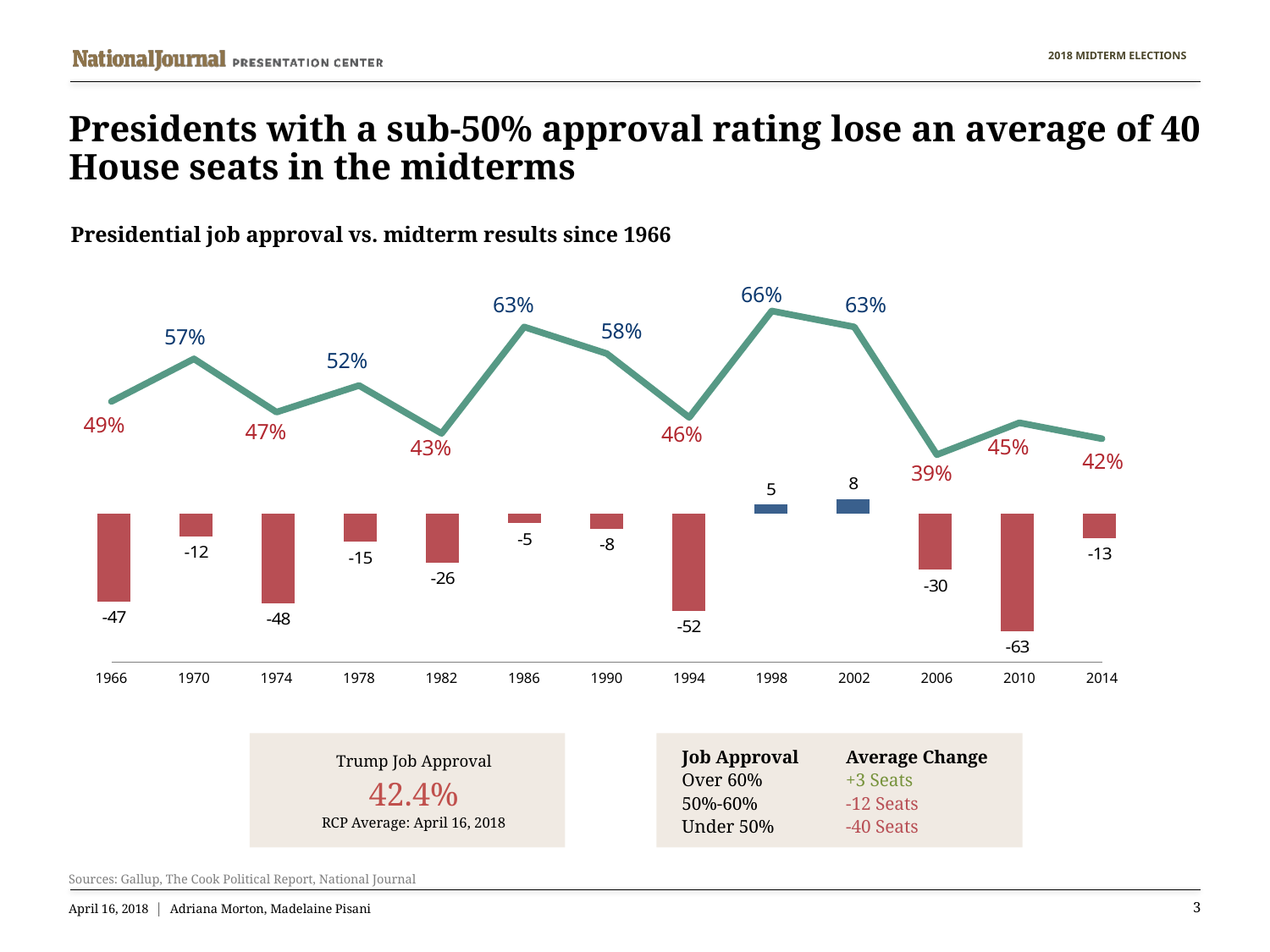
What is the difference between the approval rating in 1986 and in 1982? 20 percentage points What is the subtitle of the chart? Presidential job approval vs. midterm results since 1966 In which year was the presidential job approval rating lowest? 2006 What was the midterm House seat change in 2010? -63 Which year had a higher approval rating, 1970 or 1990? 1990 In which year was the largest loss of House seats recorded? 2010 What was the midterm House seat change in 2002? 8 In how many years shown did the president's party gain House seats? 2 What was the presidential job approval rating in 2006? 39% In which year was the presidential job approval rating highest? 1998 How many midterm years are shown on the x axis? 13 What was the presidential job approval rating in 1998? 66%